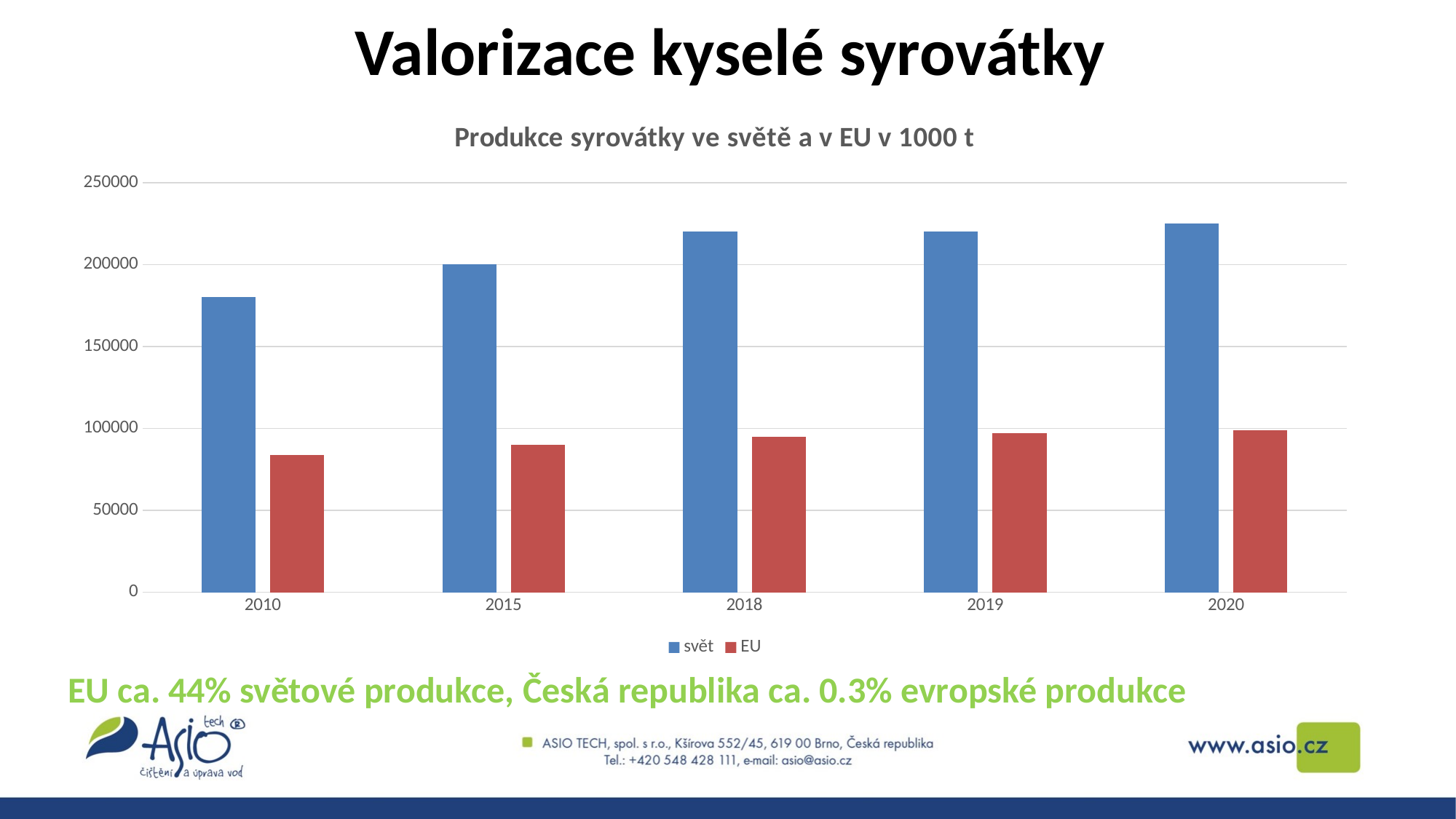
In which year is the value for svět lowest? 2010 How many years are shown on the x axis? 5 Is the value for svět in 2010 greater or less than 150000? greater Is the value for EU in 2010 greater or less than 100000? less Is the value for svět in 2018 greater or less than 200000? greater Do the values for svět rise or fall from 2010 to 2020? rise What kind of chart is shown on the slide? bar chart What is the value for svět in 2015? 200000 In which year is the value for EU lowest? 2010 What is the title of the chart? Produkce syrovátky ve světě a v EU v 1000 t How many series does the legend list? 2 Which is larger in 2019, svět or EU? svět